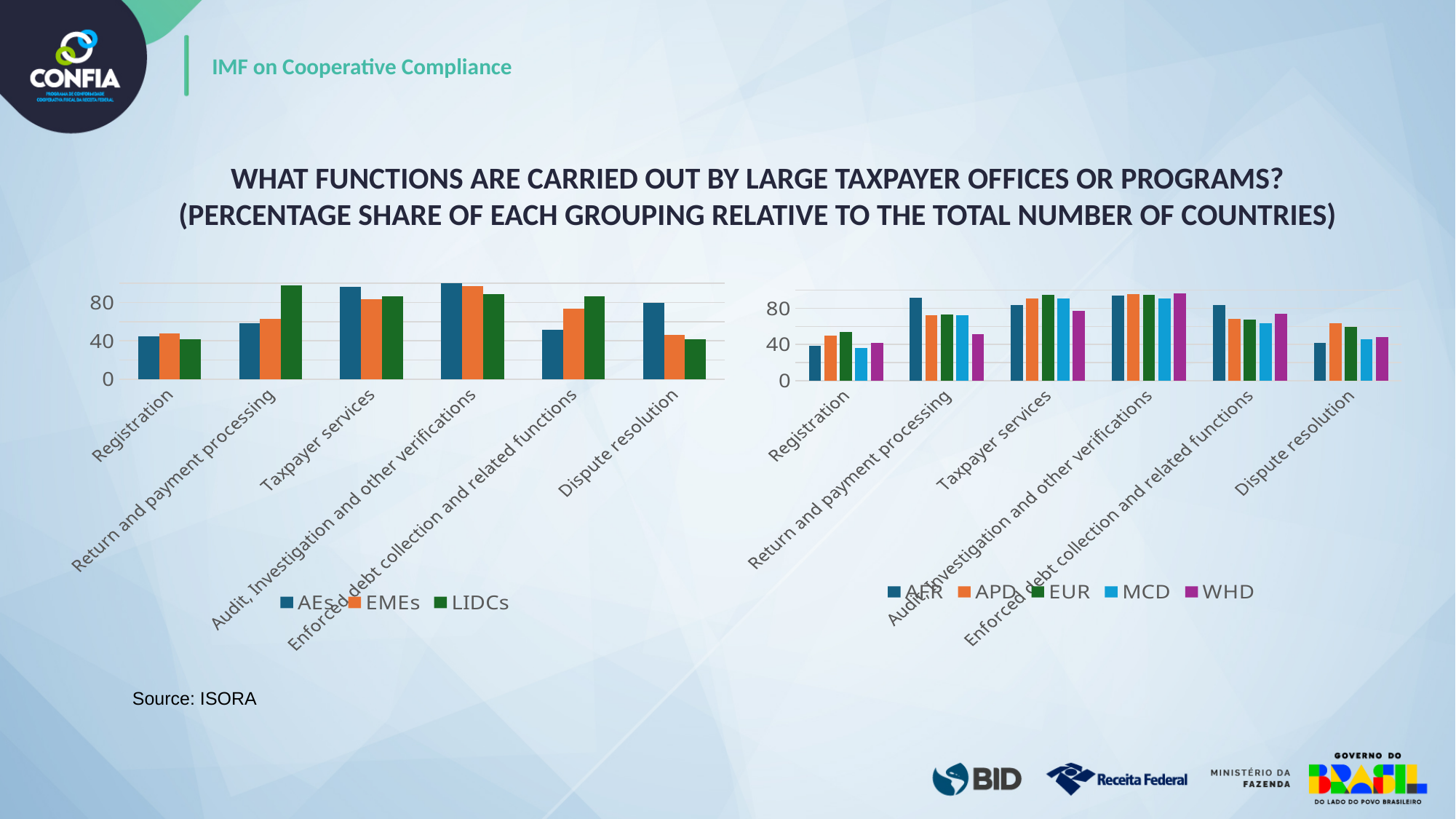
In the left chart, which series has the highest value for Return and payment processing? LIDCs In the left chart, is the LIDCs value for Return and payment processing greater or less than 80? greater How many series does the legend of the left chart list? 3 How many series does the legend of the right chart list? 5 In the left chart, which is larger: the AEs value for Taxpayer services or the EMEs value for Dispute resolution? AEs value for Taxpayer services In the right chart, is the APD value for Return and payment processing greater or less than 80? less What kind of chart is the left chart? bar chart In the right chart, is the WHD value for Audit, Investigation and other verifications greater or less than 80? greater In the right chart, which series has the lowest value for Return and payment processing? WHD In the left chart, which series has the highest value for Dispute resolution? AEs How many categories are shown on the x axis of the left chart? 6